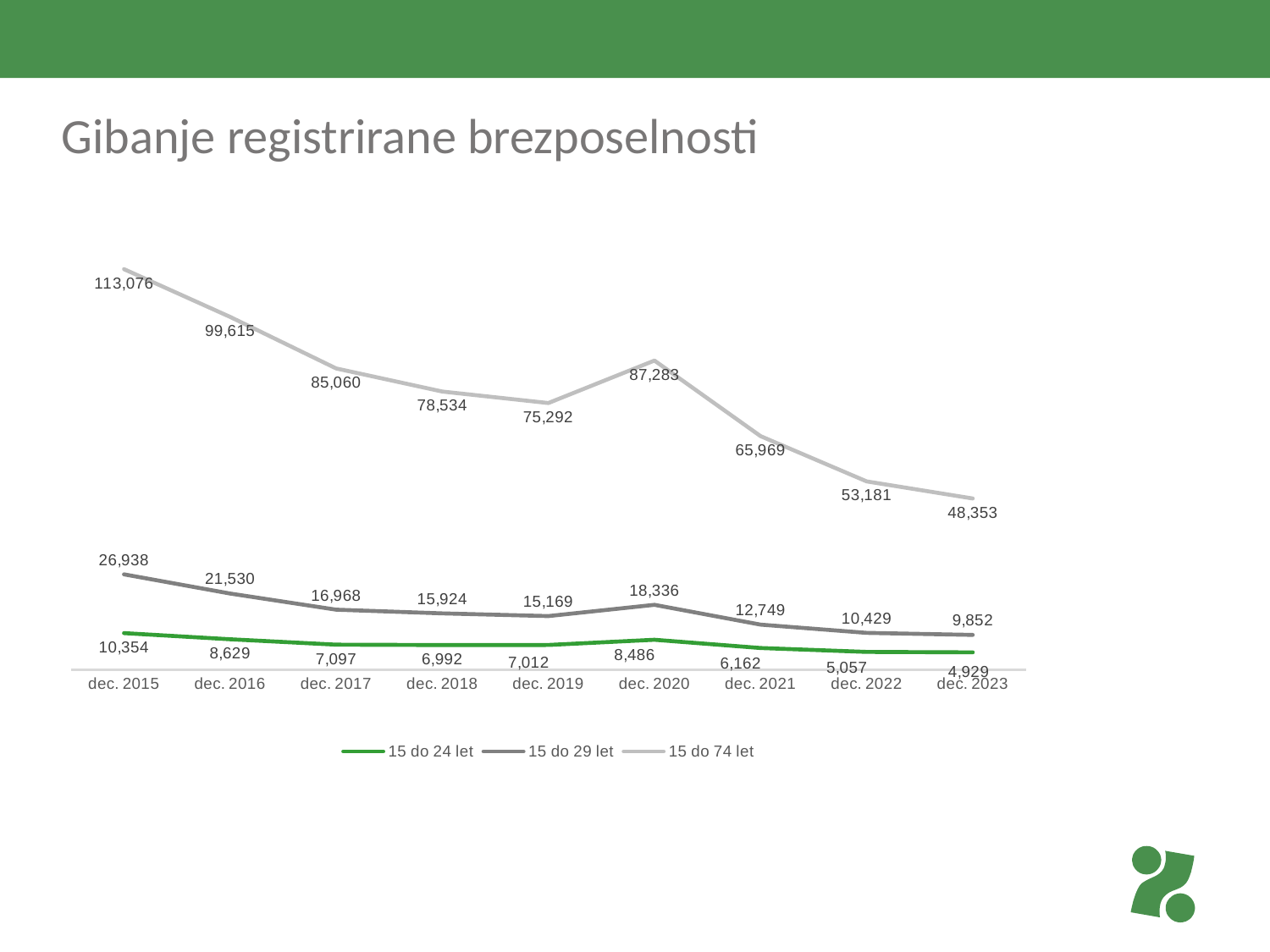
What is the title of the chart on the slide? Gibanje registrirane brezposelnosti How many series does the legend list? 3 Which is larger for the 15 do 24 let series: dec. 2019 or dec. 2020? dec. 2020 What is the difference between the 15 do 74 let values in dec. 2015 and dec. 2023? 64,723 In which period is the 15 do 29 let series at its highest? dec. 2015 What is the value for the 15 do 29 let series in dec. 2023? 9,852 What is the value for the 15 do 24 let series in dec. 2020? 8,486 What is the difference between the 15 do 29 let and 15 do 24 let values in dec. 2020? 9,850 How many time points are plotted on the x axis? 9 What kind of chart is shown on the slide? line chart In which period is the 15 do 74 let series at its lowest? dec. 2023 What is the value for the 15 do 74 let series in dec. 2015? 113,076